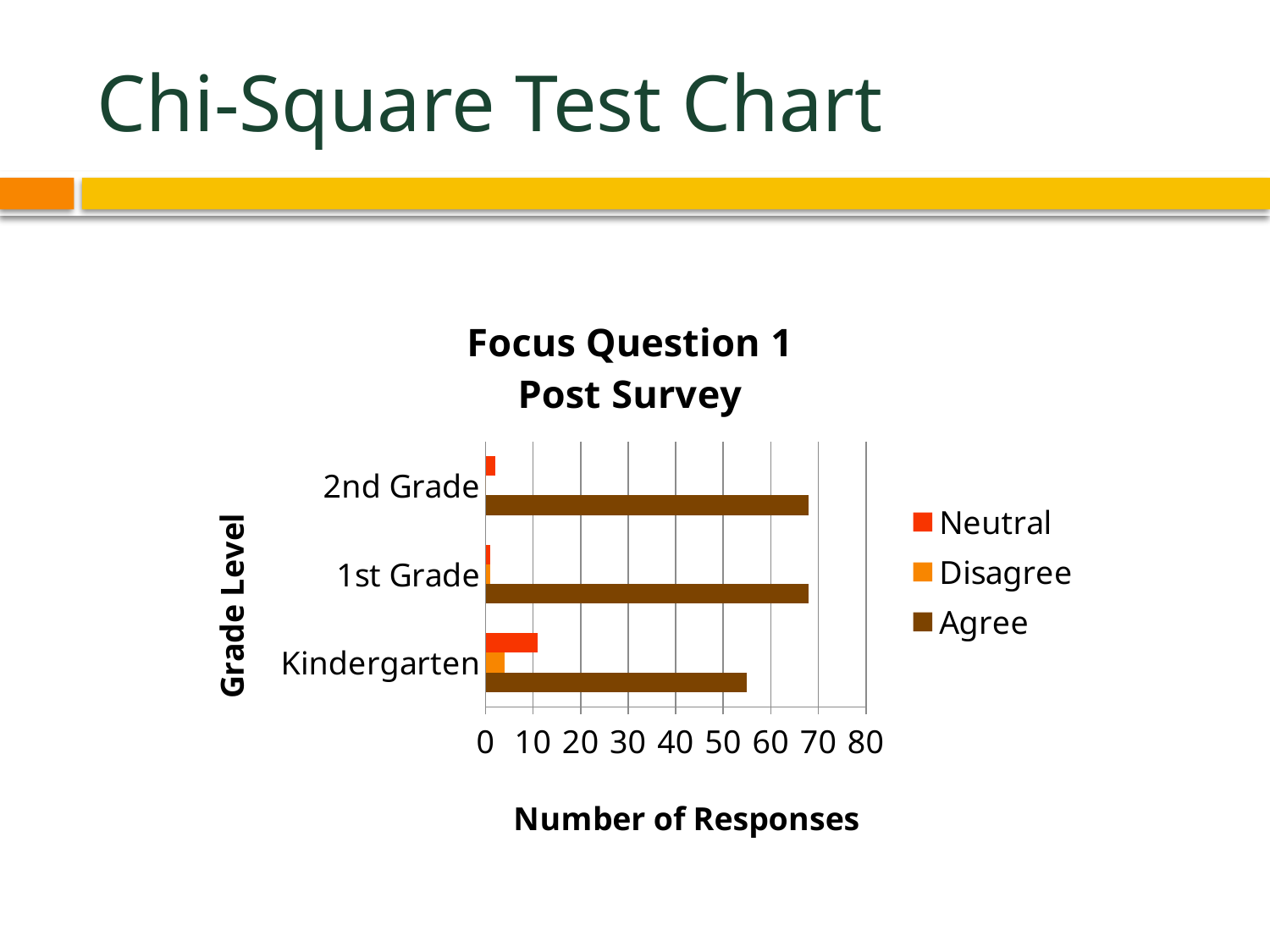
How many grade levels are shown on the chart? 3 What kind of chart is shown on the slide? bar chart Is the Agree value for Kindergarten greater or less than 50? greater Is the Agree value for Kindergarten greater or less than 60? less Which grade level has the highest Neutral value? Kindergarten Is the Neutral value for Kindergarten greater or less than 20? less How many series does the legend list? 3 Which series are listed in the legend? Neutral, Disagree, Agree Which grade level has the lowest Agree value? Kindergarten Which is larger, the Agree value for Kindergarten or the Agree value for 2nd Grade? 2nd Grade What is the title of the chart? Focus Question 1 Post Survey